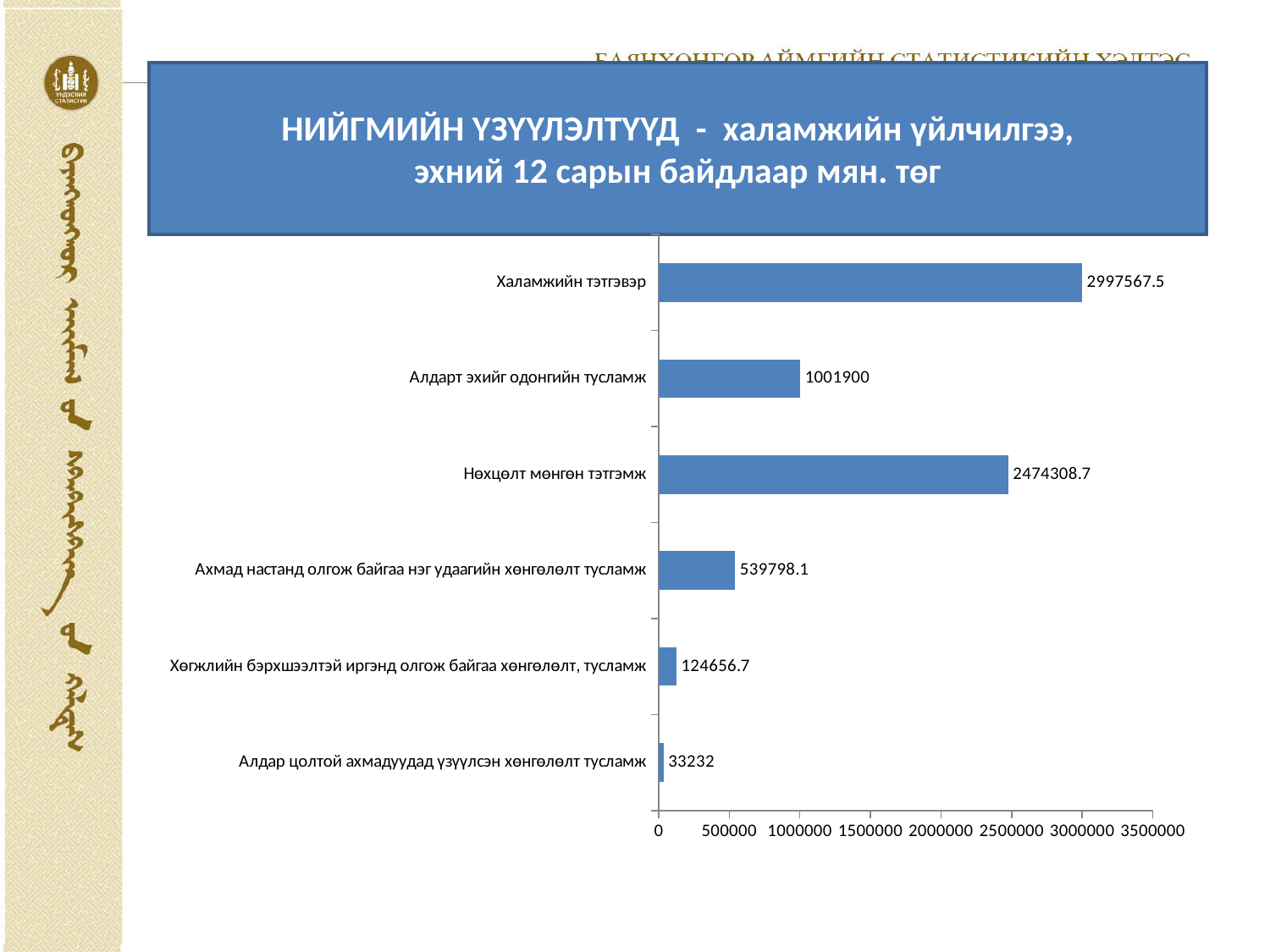
What is the value for Халамжийн тэтгэвэр? 2997567.5 What is the value for Алдар цолтой ахмадуудад үзүүлсэн хөнгөлөлт тусламж? 33232 What type of chart is shown on the slide? bar chart What is the difference between the values for Халамжийн тэтгэвэр and Нөхцөлт мөнгөн тэтгэмж? 523258.8 Which category has the highest value? Халамжийн тэтгэвэр What is the value for Алдарт эхийг одонгийн тусламж? 1001900 How many categories are shown in the chart? 6 What is the difference between the values for Хөгжлийн бэрхшээлтэй иргэнд олгож байгаа хөнгөлөлт, тусламж and Алдар цолтой ахмадуудад үзүүлсэн хөнгөлөлт тусламж? 91424.7 Which category has the lowest value? Алдар цолтой ахмадуудад үзүүлсэн хөнгөлөлт тусламж Is the value for Нөхцөлт мөнгөн тэтгэмж greater or less than 2000000? greater What is the value for Нөхцөлт мөнгөн тэтгэмж? 2474308.7 Which is larger: the value for Алдарт эхийг одонгийн тусламж or the value for Ахмад настанд олгож байгаа нэг удаагийн хөнгөлөлт тусламж? Алдарт эхийг одонгийн тусламж